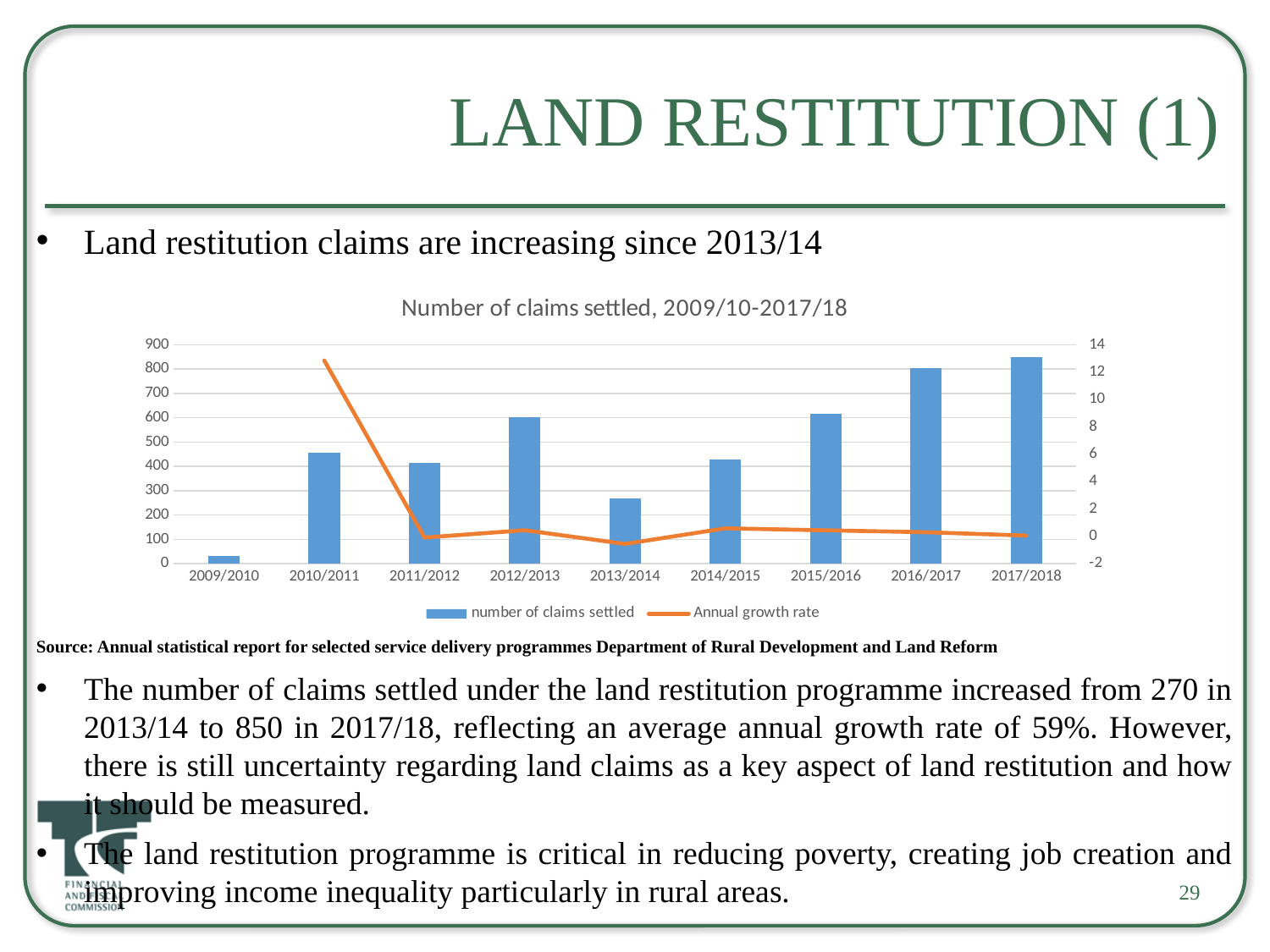
Which year has the highest annual growth rate? 2010/2011 Which year had more claims settled, 2012/2013 or 2013/2014? 2012/2013 What kind of chart is shown on the slide? A combined bar and line chart How many series does the chart legend list? 2 Do the number of claims settled rise or fall from 2013/2014 to 2017/2018? rise What are the two series named in the legend? number of claims settled; Annual growth rate What is the title of the chart? Number of claims settled, 2009/10-2017/18 Is the number of claims settled in 2013/2014 greater or less than 300? less Which year has the lowest number of claims settled? 2009/2010 Which year has the highest number of claims settled? 2017/2018 Is the number of claims settled in 2017/2018 greater or less than 800? greater How many years (categories) are shown on the x axis? 9